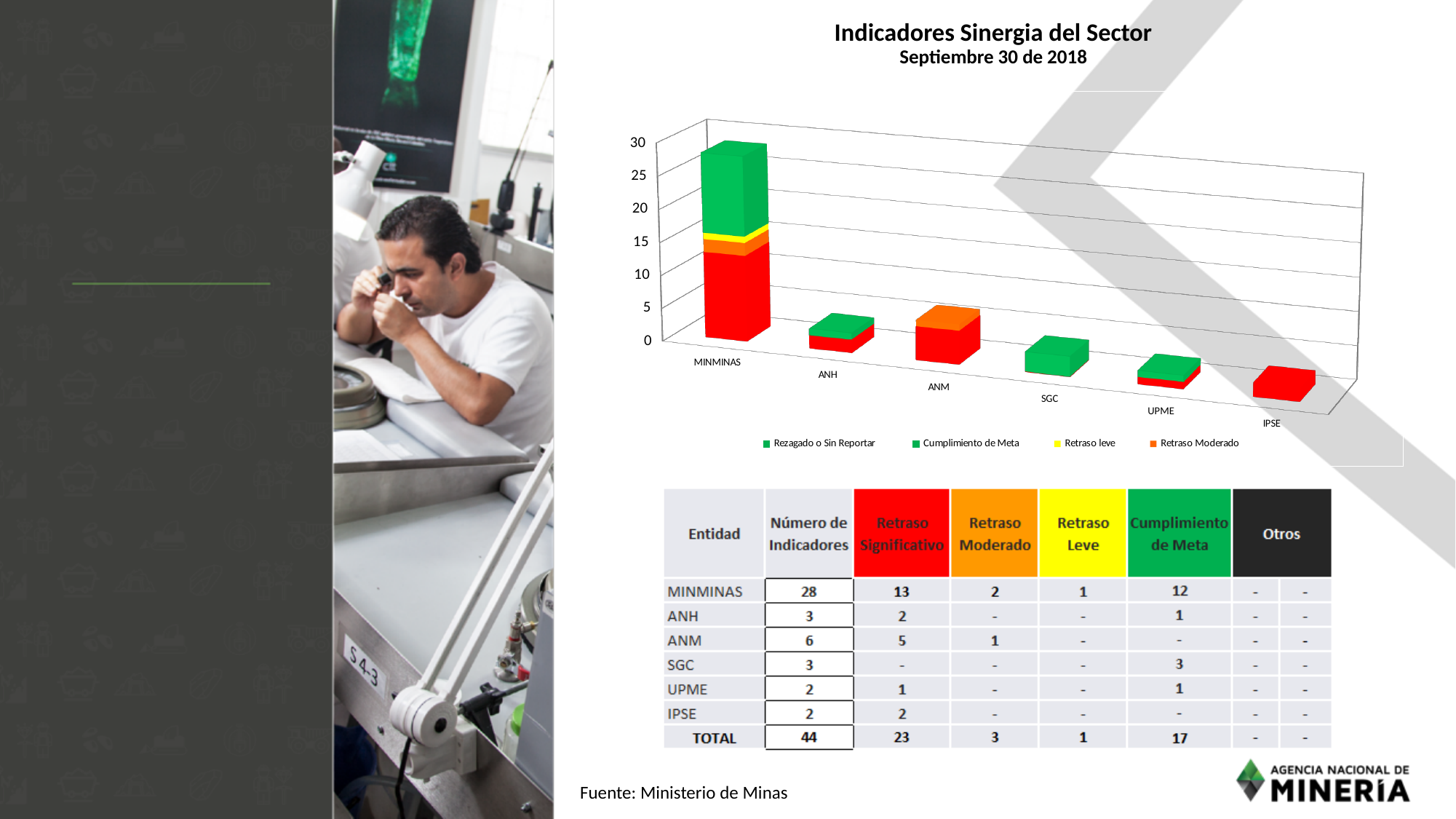
How many entities (categories) are shown on the x axis of the chart? 6 How many indicators does ANM have in total? 6 What is the value of 'Cumplimiento de Meta' for SGC? 3 Is the total height of the ANM bar greater or less than 10? less Which entity has the tallest stacked bar in the chart? MINMINAS What is the total number of indicators for MINMINAS, as shown in the table below the chart? 28 Is the total height of the MINMINAS bar greater or less than 25? greater How many series does the chart legend list? 4 What is the title of the chart? Indicadores Sinergia del Sector What kind of chart is shown on the slide? Stacked bar chart Which bar is taller, MINMINAS or ANM? MINMINAS What is the difference between the total indicators of MINMINAS and ANM? 22